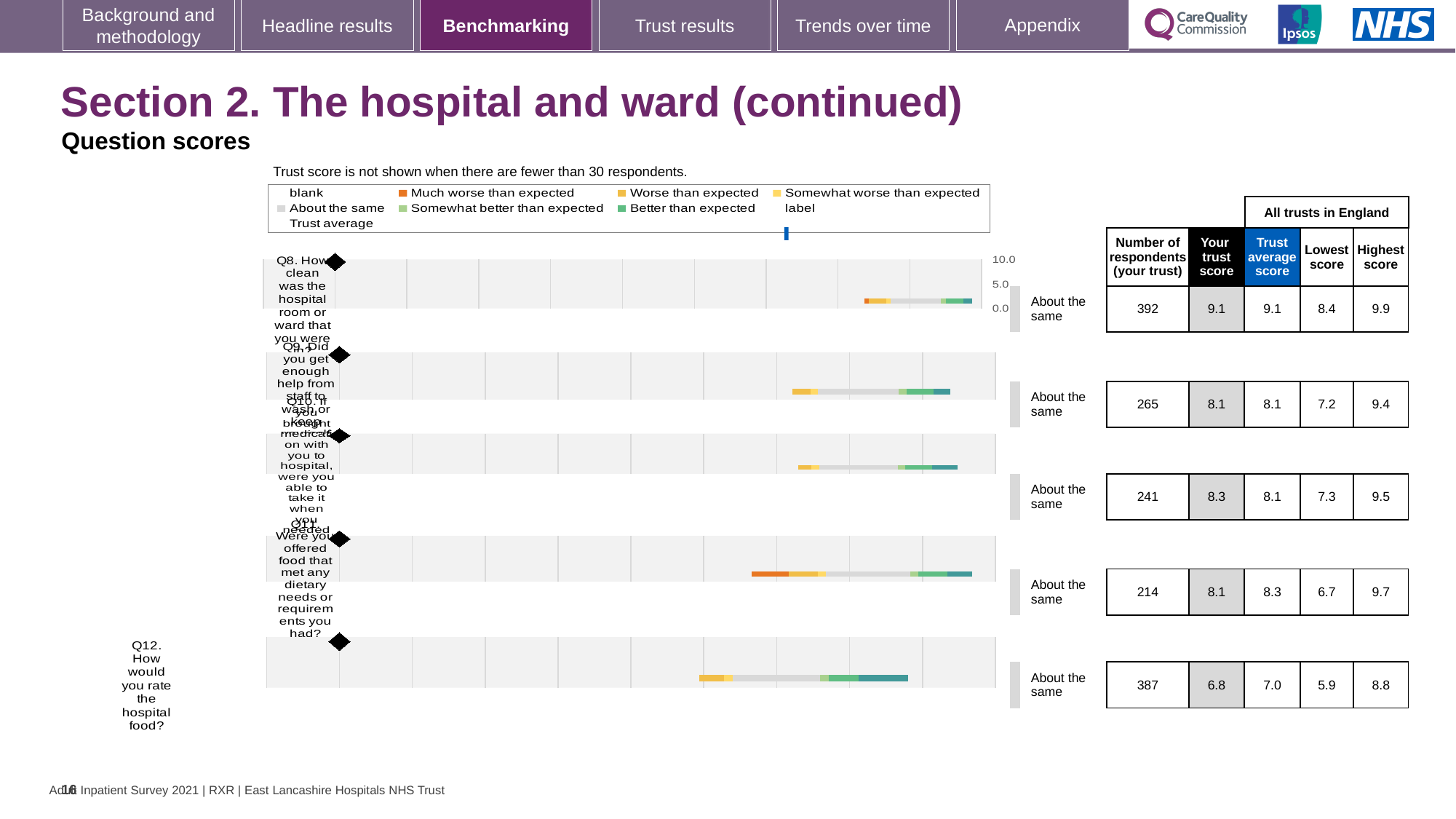
What kind of chart is used to show the question scores on this slide? bar chart What is the difference between the trust average score and your trust score for Q12? 0.2 What is the highest value shown on the chart's score axis? 10.0 How many questions (categories) are plotted in the chart? 5 Which question has the highest 'Your trust score'? Q8 What is the highest score across all trusts in England for Q11 (offered food that met dietary needs)? 9.7 Which question has the lowest 'Your trust score'? Q12 How many respondents from your trust answered Q12 (how would you rate the hospital food)? 387 For Q10, which is larger: your trust score or the trust average score? Your trust score What is the 'Your trust score' for Q8 (how clean was the hospital room or ward)? 9.1 What is the difference between the highest score (9.9) and the lowest score (8.4) for Q8? 1.5